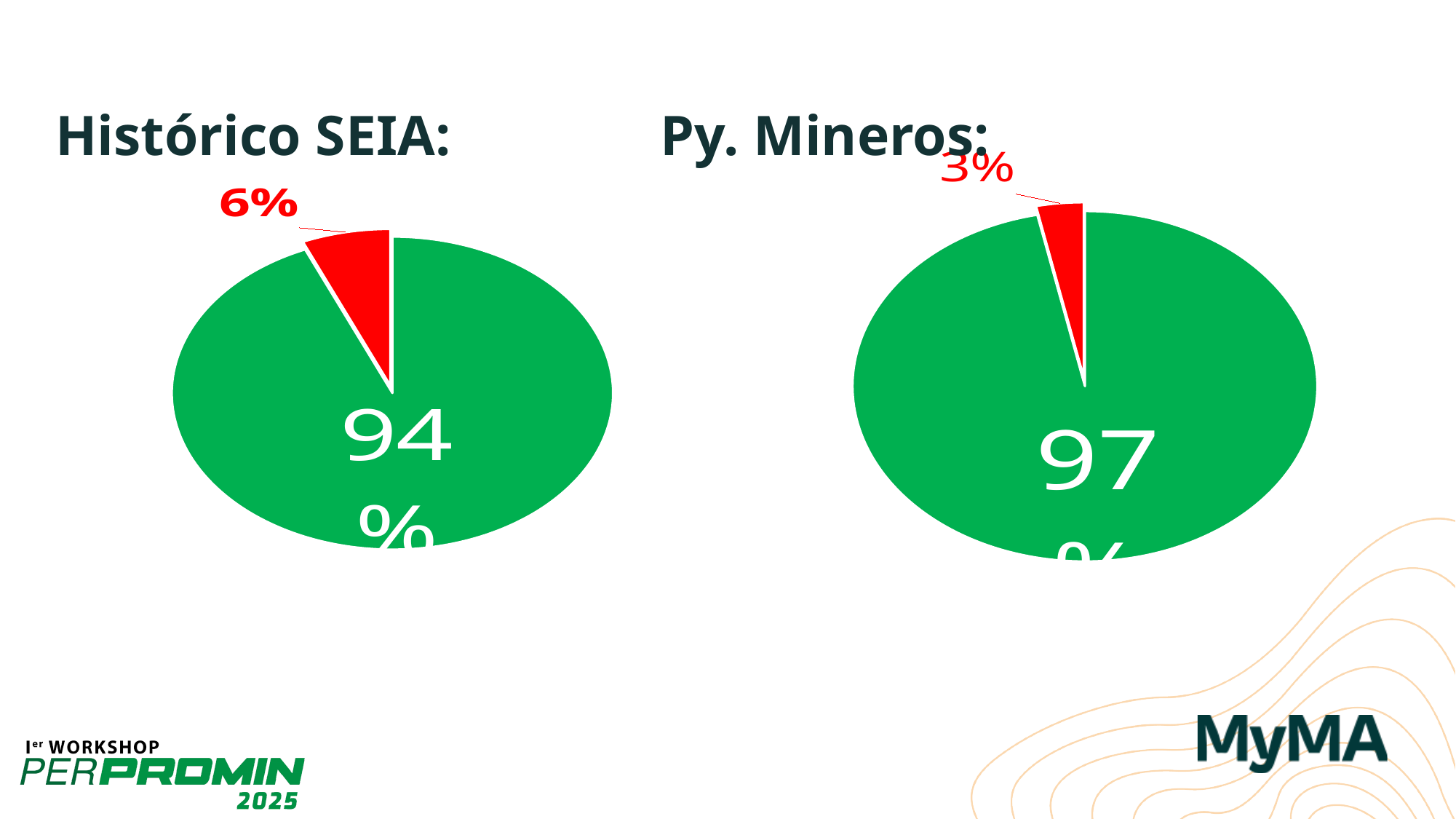
In the "Py. Mineros:" pie chart, which slice is the smallest? the red slice (3%) In the "Py. Mineros:" pie chart, what share does the green slice represent? 97% What kind of chart is shown under the heading "Histórico SEIA:"? pie chart In the "Py. Mineros:" pie chart, what share does the red slice represent? 3% What kind of chart is shown under the heading "Py. Mineros:"? pie chart In the "Histórico SEIA:" pie chart, what share does the red slice represent? 6% Which is larger: the red slice in the "Histórico SEIA:" pie chart or the red slice in the "Py. Mineros:" pie chart? the red slice in Histórico SEIA (6%) How many slices does the "Histórico SEIA:" pie chart have? 2 In the "Histórico SEIA:" pie chart, which slice is the largest? the green slice (94%) What is the difference between the green share in the "Py. Mineros:" pie chart and the green share in the "Histórico SEIA:" pie chart? 3 percentage points How many slices does the "Py. Mineros:" pie chart have? 2